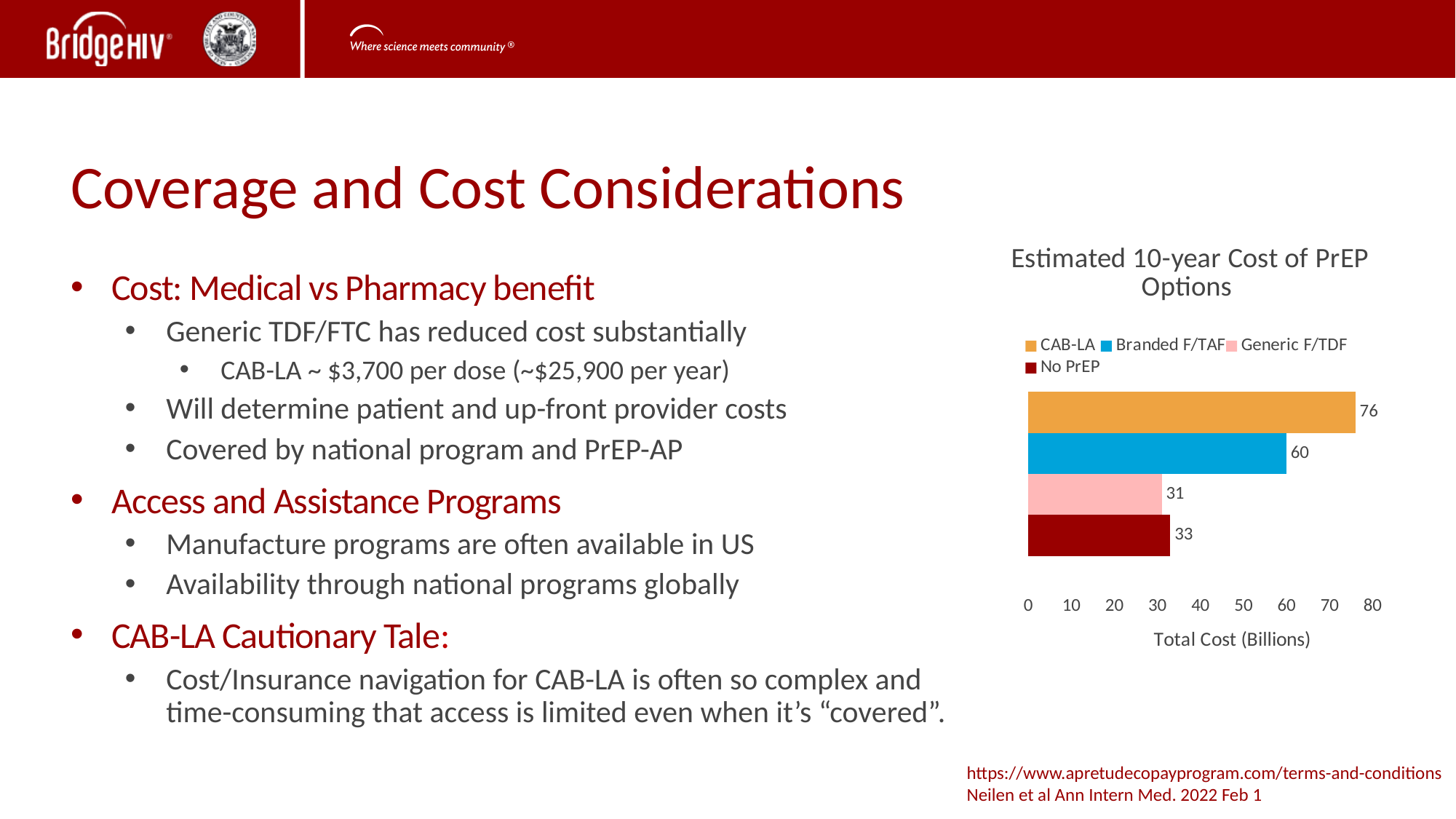
Which PrEP option has the highest estimated 10-year cost? CAB-LA What is the estimated 10-year cost for Generic F/TDF? 31 Which has a higher estimated 10-year cost, Branded F/TAF or Generic F/TDF? Branded F/TAF What type of chart is used to show the estimated 10-year cost of PrEP options? Bar chart What is the difference between the estimated 10-year cost of CAB-LA and Branded F/TAF? 16 How many series does the chart legend list? 4 What is the estimated 10-year cost for CAB-LA? 76 How many PrEP options are shown in the chart? 4 What is the estimated 10-year cost for Branded F/TAF? 60 What is the estimated 10-year cost for No PrEP? 33 What is the label of the x axis of the chart? Total Cost (Billions) Which option has the lowest estimated 10-year cost? Generic F/TDF